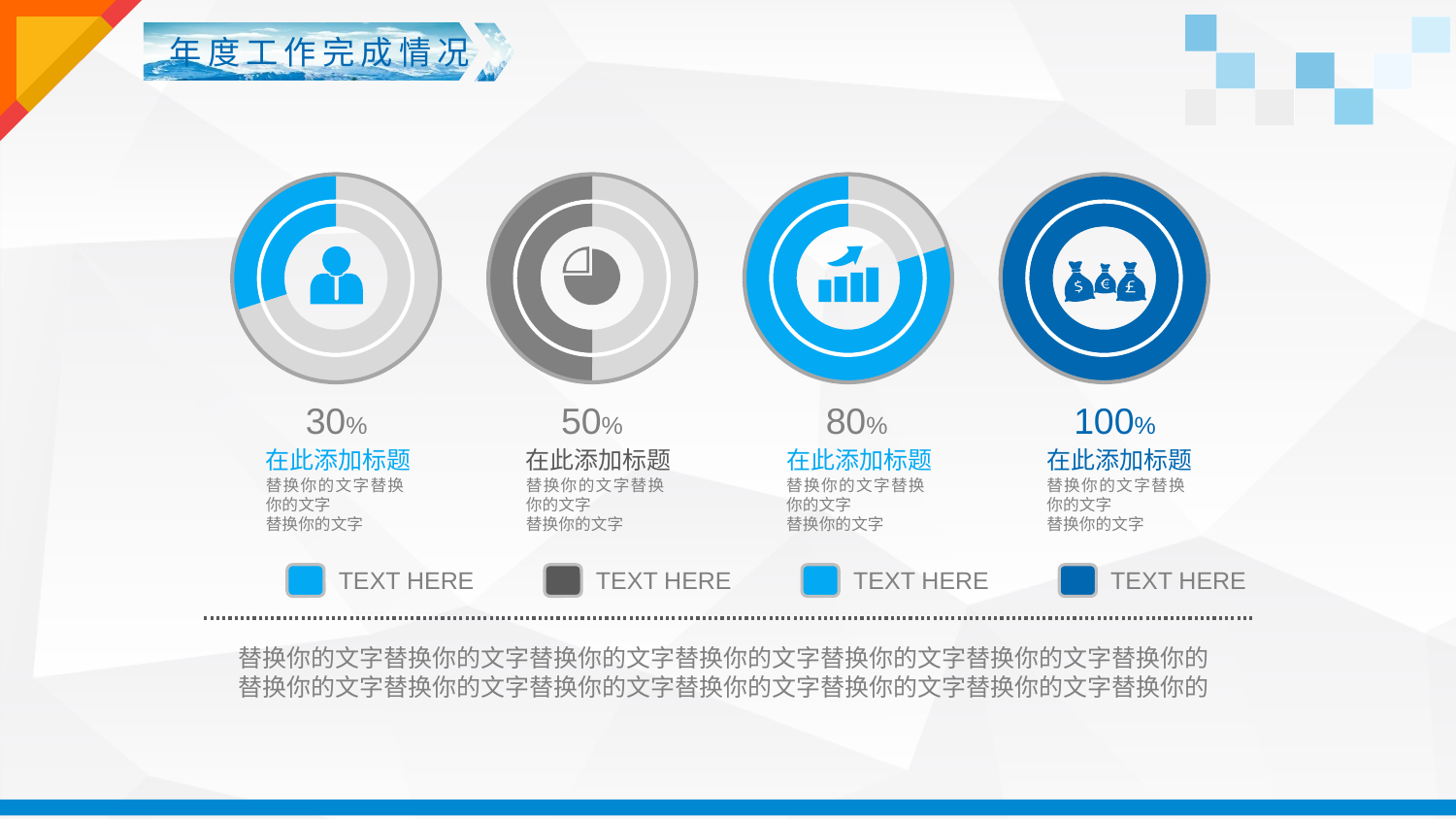
How many donut charts are shown on the slide? 4 Which of the four donut charts shows the highest percentage? The fourth (rightmost) chart, 100% What percentage is shown below the fourth (rightmost) donut chart with the money-bag icon? 100% What percentage is shown below the first (leftmost) donut chart with the person icon? 30% What kind of chart is used to display the percentages on this slide? Donut chart What percentage is shown below the third donut chart with the rising bar-chart icon? 80% Which is larger, the percentage of the second donut chart or the third donut chart? The third donut chart (80%) What is the difference between the percentage of the third donut chart and the first donut chart? 50 percentage points What colour is the filled ring of the second donut chart (50%)? Gray Which of the four donut charts shows the lowest percentage? The first (leftmost) chart, 30% What percentage is shown below the second donut chart with the pie-chart icon? 50% Do the percentages rise or fall from the leftmost chart to the rightmost chart? Rise